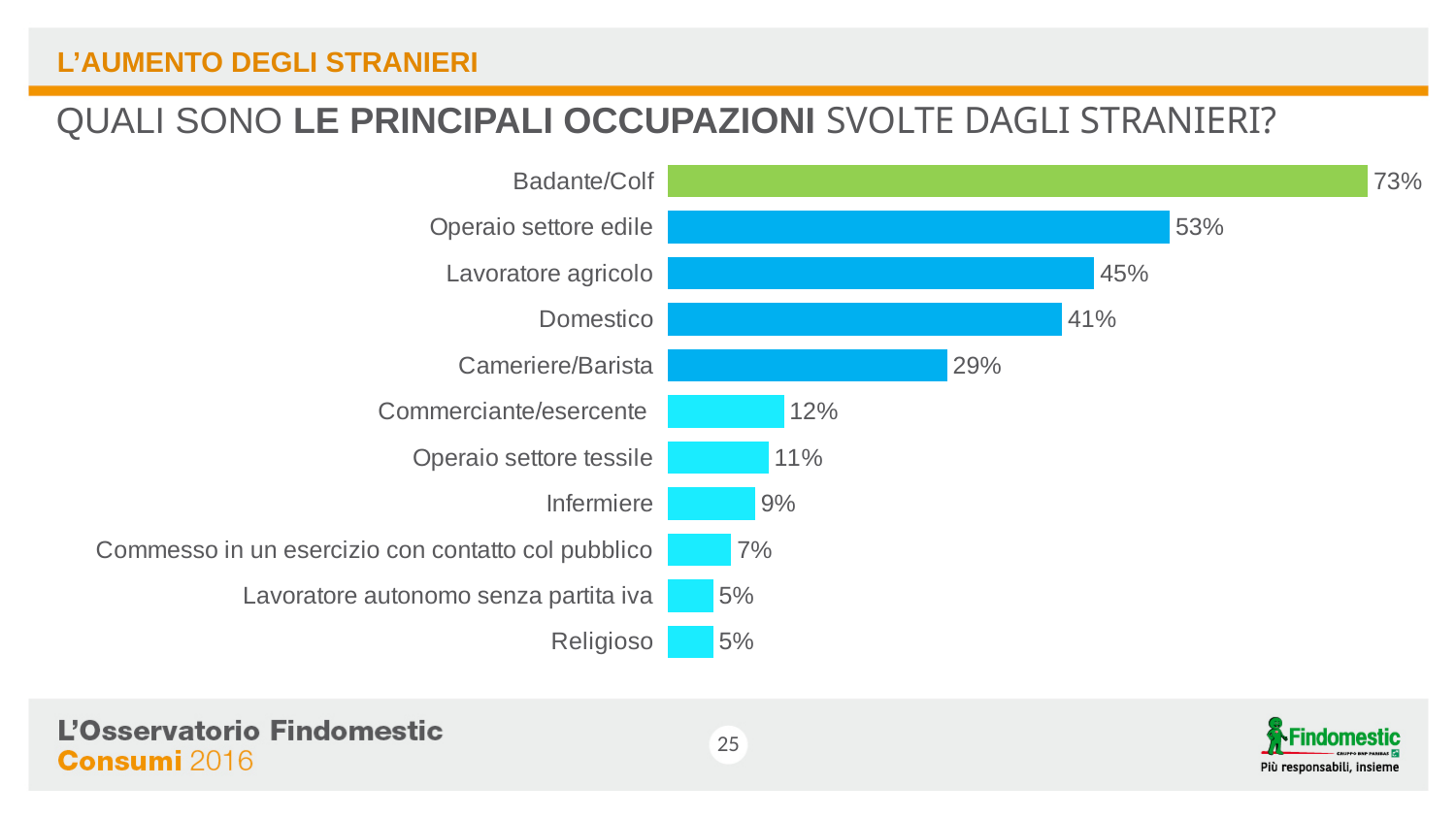
What is the value for Infermiere? 9% What is the difference between Badante/Colf and Operaio settore edile? 20% Which is larger, Cameriere/Barista or Commerciante/esercente? Cameriere/Barista What is the difference between Operaio settore edile and Domestico? 12% What kind of chart is shown on the slide? Bar chart What is the value for Commesso in un esercizio con contatto col pubblico? 7% What is the value for Badante/Colf? 73% Which two occupations share the lowest value? Lavoratore autonomo senza partita iva and Religioso Which occupation has the highest value? Badante/Colf How many occupations are shown in the chart? 11 What is the value for Lavoratore agricolo? 45% Which bar is coloured green rather than blue? Badante/Colf